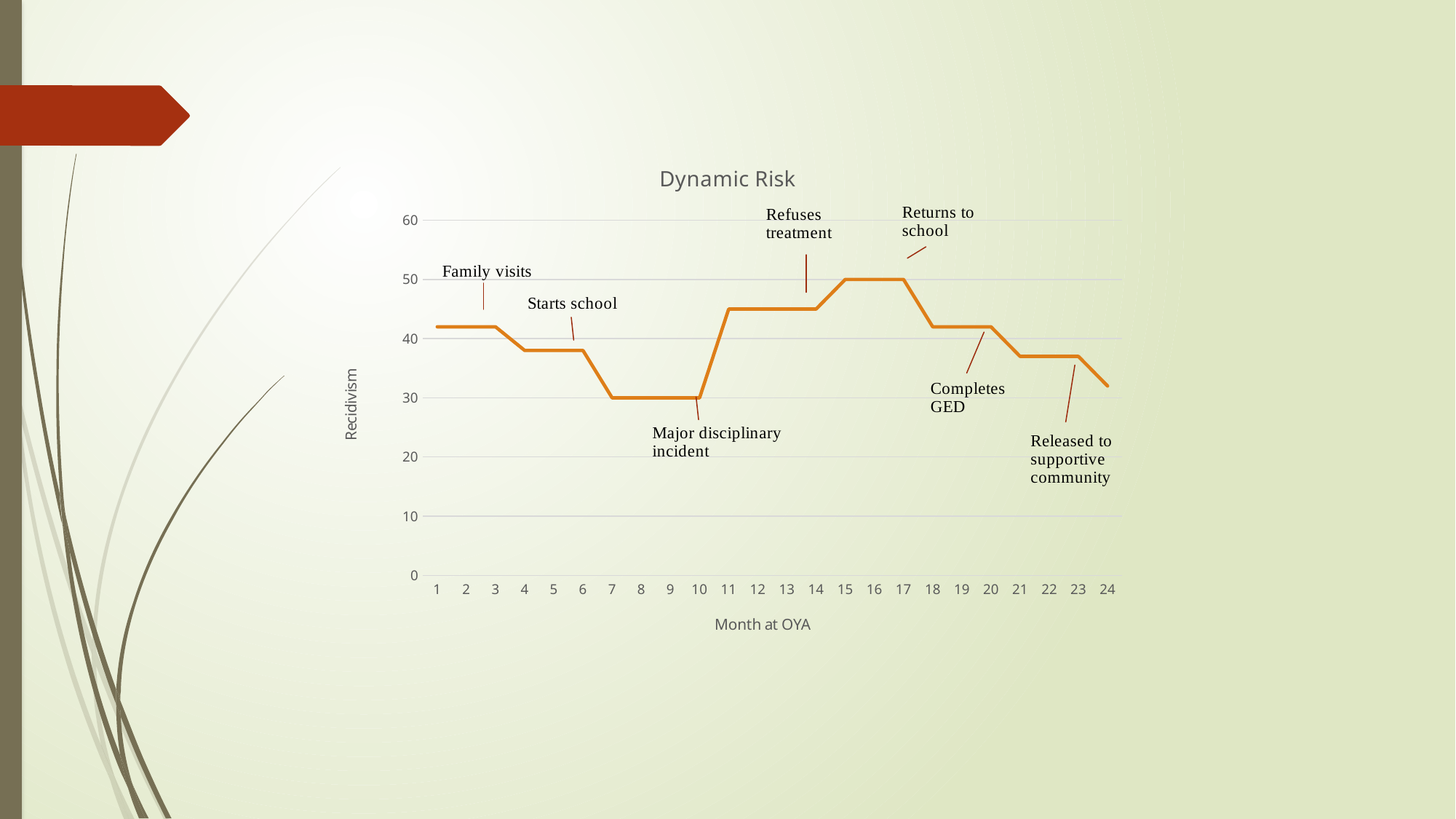
How many months are plotted along the x axis? 24 What is the difference between the recidivism value at month 16 and at month 8? 20 Is the recidivism value at month 12 greater or less than 40? greater What is the label on the x axis of the chart? Month at OYA What is the highest recidivism value reached on the chart? 50 What is the lowest recidivism value reached on the chart? 30 Is the recidivism value at month 5 greater or less than 40? less What kind of chart is shown on the slide? line chart What is the recidivism value at month 8? 30 What is the title of the chart? Dynamic Risk Which has the higher recidivism value, month 3 or month 22? month 3 What is the recidivism value at month 16? 50